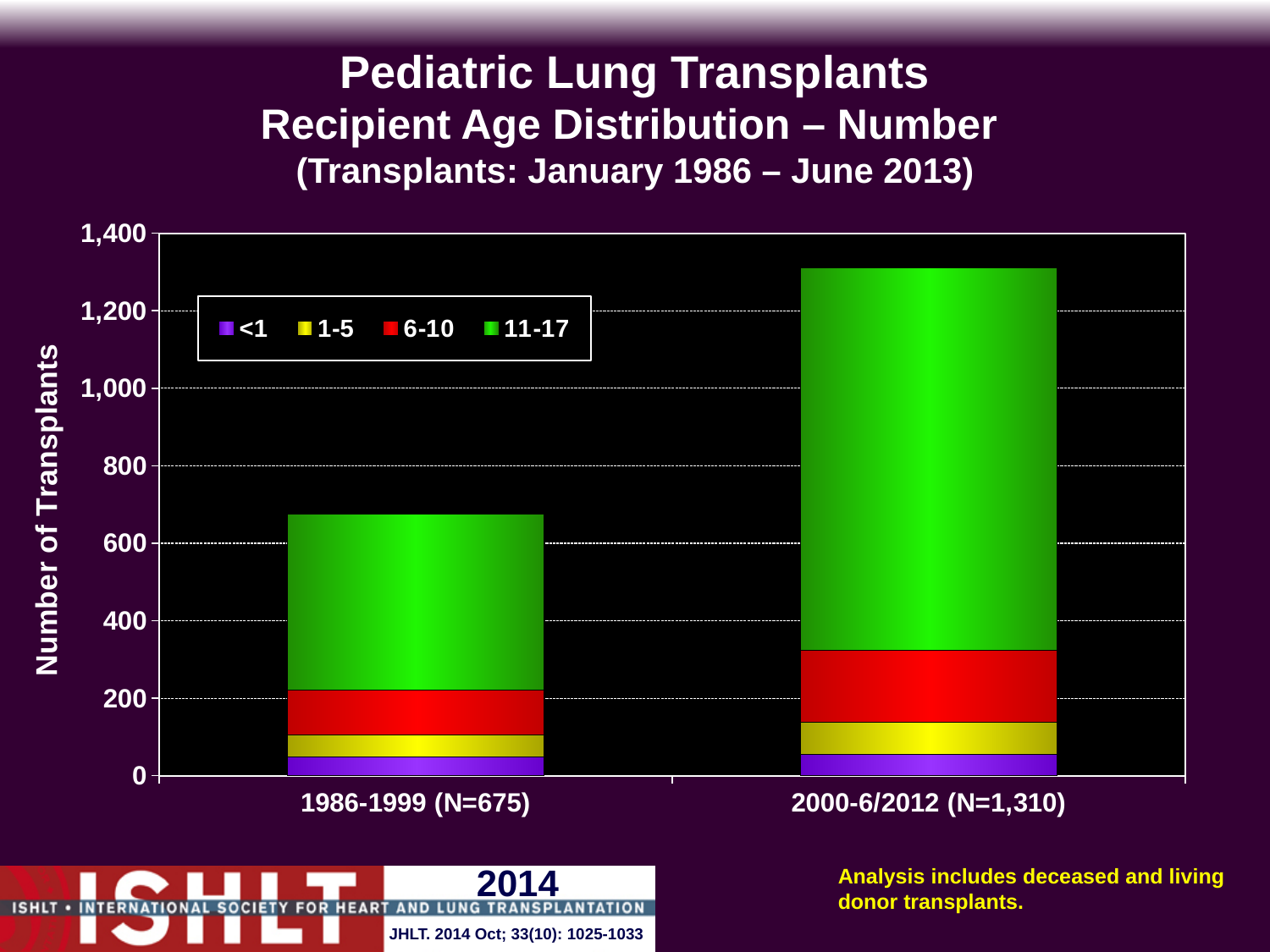
Is the total for the 2000-6/2012 bar greater or less than 1,200? greater What is the total number of transplants for the 2000-6/2012 bar? 1,310 Which period has the higher total number of transplants? 2000-6/2012 What is the difference in total transplants between 2000-6/2012 and 1986-1999? 635 How many time-period categories are shown on the x axis? 2 Which colour represents the 11-17 age group in the legend? Green Does the total number of transplants rise or fall from the 1986-1999 period to the 2000-6/2012 period? rise How many age-group series does the legend list? 4 What is the total number of transplants for the 1986-1999 bar? 675 What kind of chart is shown on the slide? Stacked bar chart Is the total for the 1986-1999 bar greater or less than 600? greater Which is larger, the total for 1986-1999 or the total for 2000-6/2012? 2000-6/2012